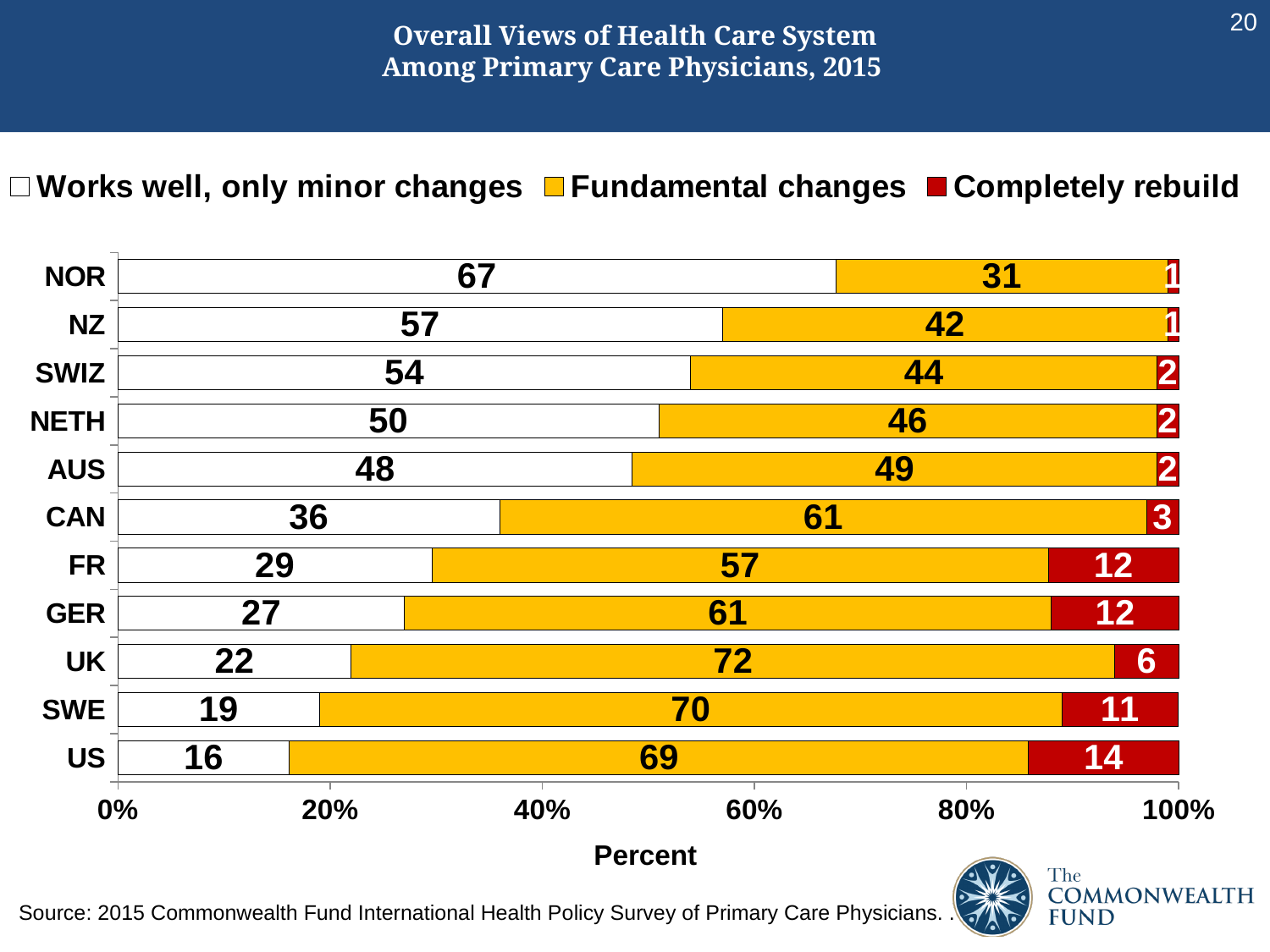
Which country has the highest value for 'Completely rebuild'? US What is the difference between the 'Works well, only minor changes' values for NOR and NZ? 10 How many countries are shown in the chart? 11 What type of chart is shown on the slide? Stacked bar chart Which country has the highest value for 'Works well, only minor changes'? NOR Which is larger: the 'Fundamental changes' value for FR or for GER? GER Which country has the highest value for 'Fundamental changes'? UK What is the value for 'Fundamental changes' for CAN? 61 Which country has the lowest value for 'Works well, only minor changes'? US What is the value for 'Completely rebuild' for SWE? 11 What percentage of primary care physicians in the US said the health care system works well and needs only minor changes? 16 How many series does the legend list? 3